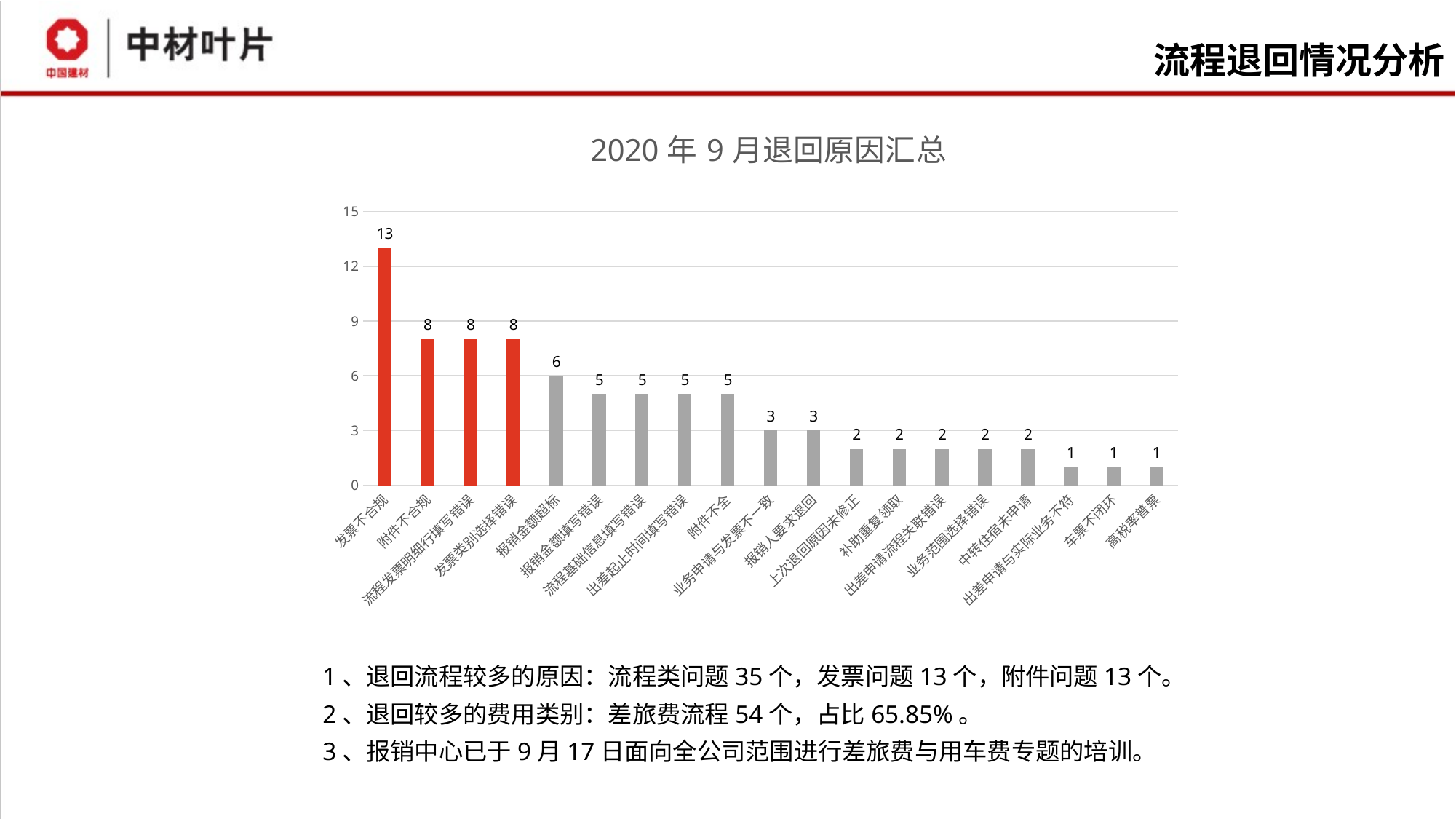
Do the values rise or fall from left to right along the x axis? fall How many categories are shown in the chart? 19 What is the lowest value shown in the chart? 1 Which category has the highest value? 发票不合规 What is the title of the chart? 2020年9月退回原因汇总 What is the value for 报销金额超标? 6 What is the value for 报销人要求退回? 3 What type of chart is shown on the slide? bar chart What is the difference between the values for 发票不合规 and 附件不合规? 5 Which is larger, the value for 附件不全 or the value for 业务申请与发票不一致? 附件不全 Is the value for 发票不合规 greater or less than 12? greater What is the value for 发票不合规? 13